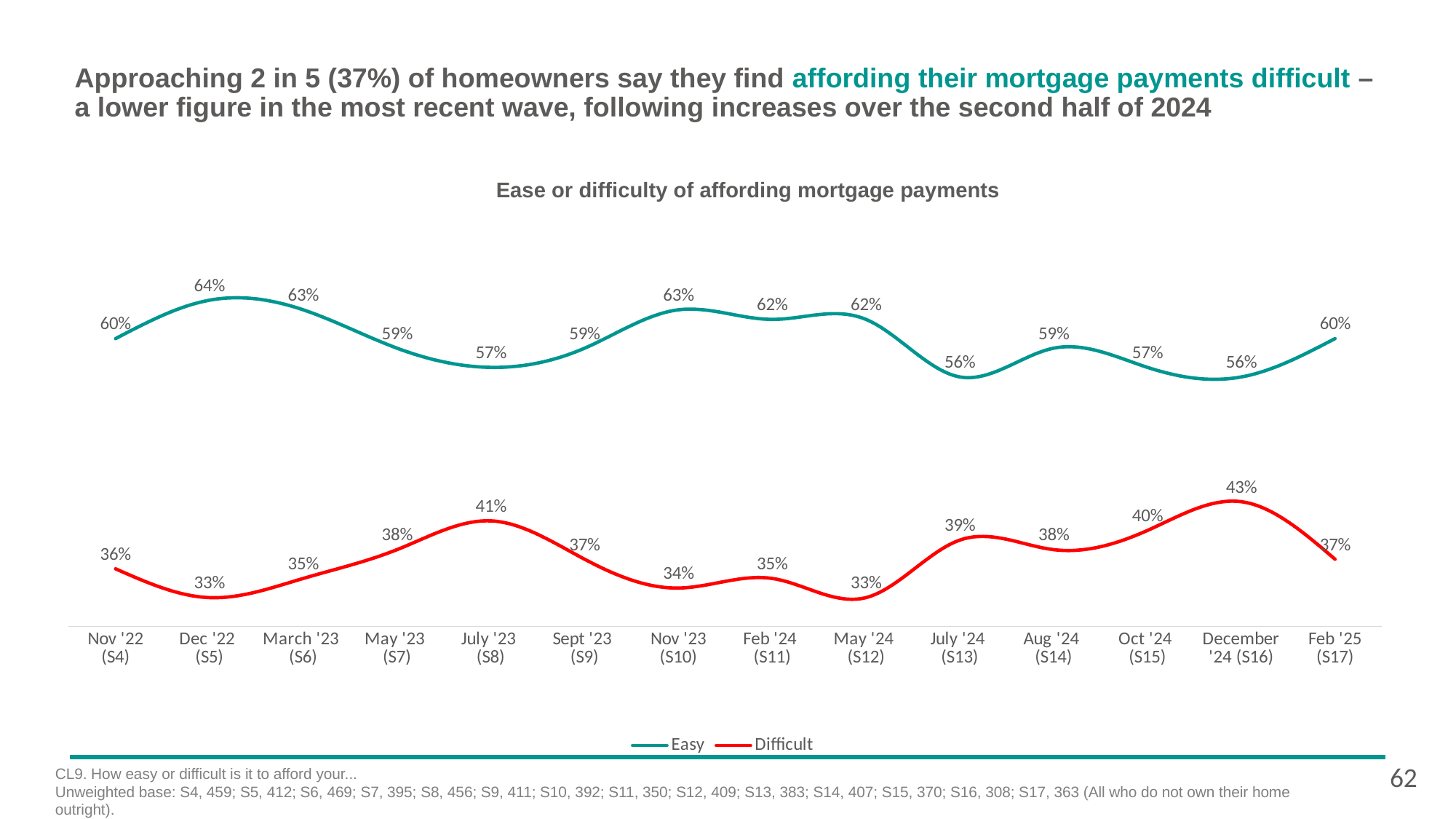
By how many percentage points did the Difficult value change from December '24 (S16) to Feb '25 (S17)? 6 percentage points How many waves (time points) are shown on the x axis? 14 What is the Easy value for Dec '22 (S5)? 64% What is the difference between the Easy and Difficult values in Feb '25 (S17)? 23 percentage points What is the Difficult value for July '23 (S8)? 41% What percentage of homeowners said affording their mortgage payments was Difficult in Feb '25 (S17)? 37% In which wave does the Difficult series reach its highest value? December '24 (S16) Did the Difficult series rise or fall between May '24 (S12) and December '24 (S16)? Rise What type of chart is shown on the slide? Line chart In which wave does the Easy series reach its highest value? Dec '22 (S5) How many series does the legend list? 2 Which is larger: the Difficult value in July '23 (S8) or in Oct '24 (S15)? July '23 (S8)